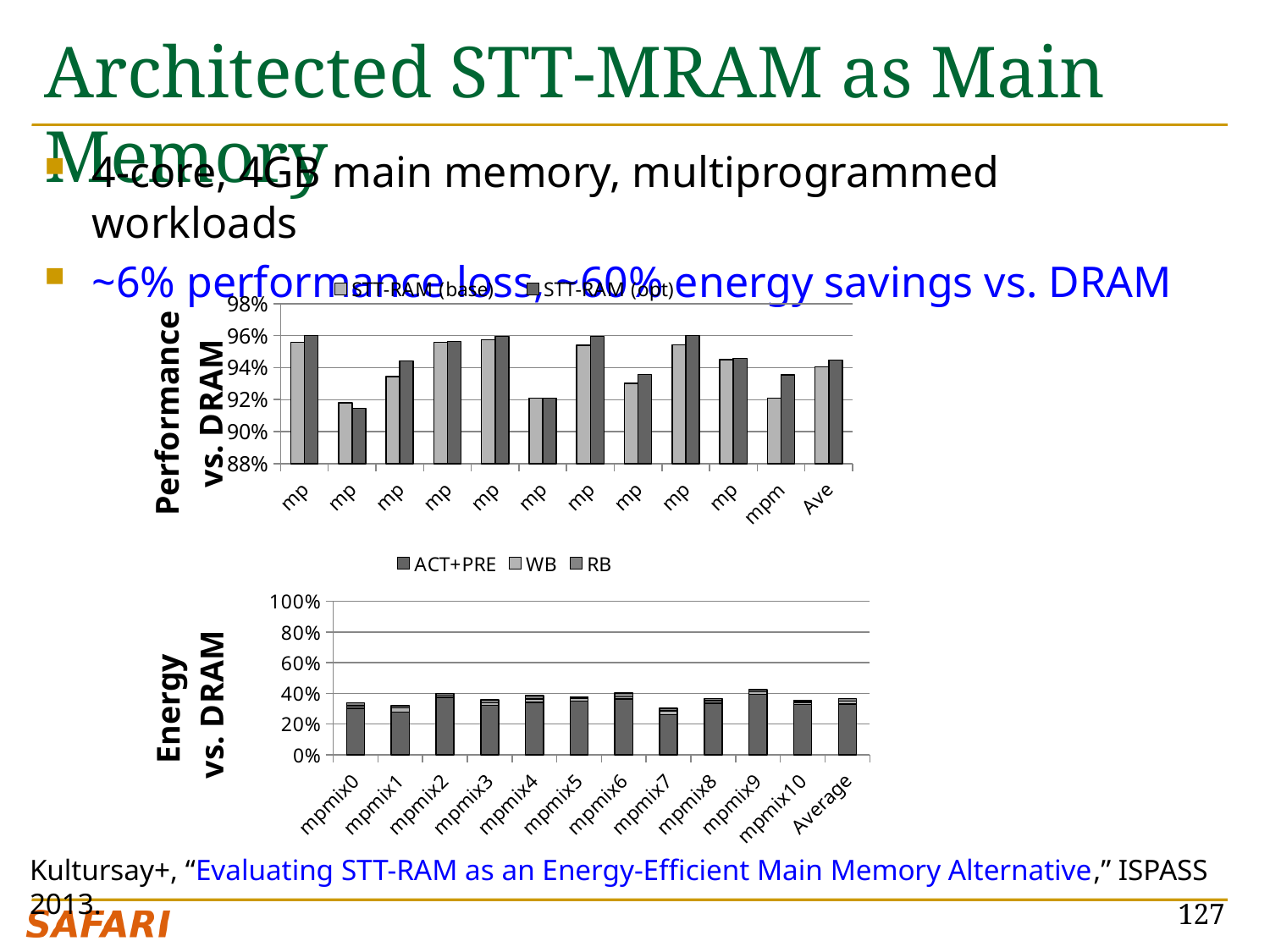
What are the legend entries of the top chart (Performance vs. DRAM)? STT-RAM (base), STT-RAM (opt) How many categories are shown on the x axis of the bottom chart (Energy vs. DRAM)? 12 In the top chart (Performance vs. DRAM), is the STT-RAM (opt) value for Ave greater or less than 96%? less How many series does the legend of the top chart (Performance vs. DRAM) list? 2 What kind of chart is the top chart (Performance vs. DRAM)? bar chart In the top chart (Performance vs. DRAM), is the STT-RAM (opt) value for Ave greater or less than 92%? greater What are the legend entries of the bottom chart (Energy vs. DRAM)? ACT+PRE, WB, RB How many series does the legend of the bottom chart (Energy vs. DRAM) list? 3 In the bottom chart (Energy vs. DRAM), is the total for mpmix7 greater or less than 40%? less What kind of chart is the bottom chart (Energy vs. DRAM)? stacked bar chart